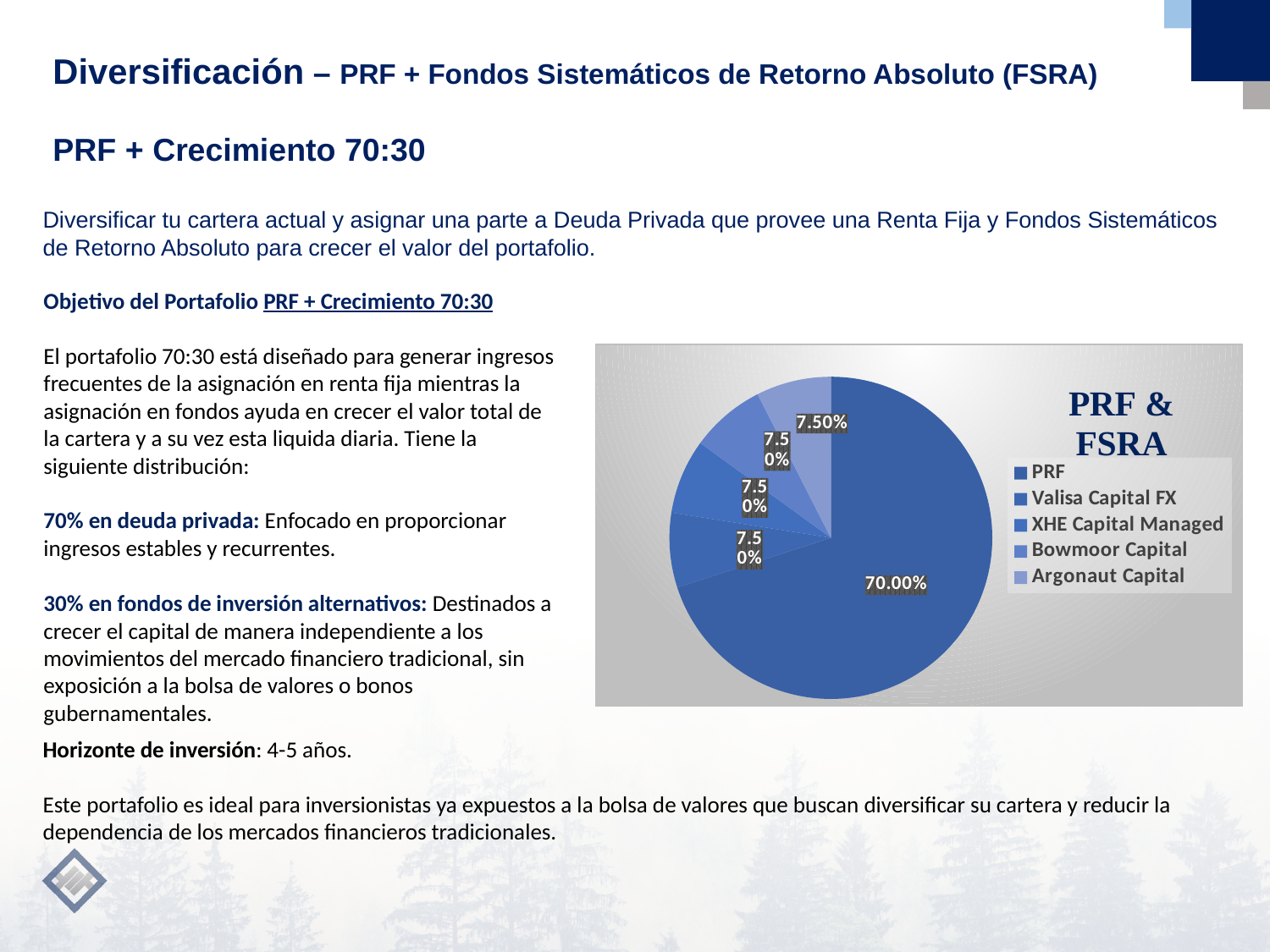
What kind of chart is shown on the slide? pie chart How many entries does the chart legend list? 5 What share of the pie does Argonaut Capital represent? 7.50% Which category has the largest slice of the pie? PRF What share of the pie does XHE Capital Managed represent? 7.50% What is the difference between the PRF slice and the Valisa Capital FX slice? 62.50% How many slices does the pie chart have? 5 What is the combined share of the four non-PRF slices (Valisa Capital FX, XHE Capital Managed, Bowmoor Capital, Argonaut Capital)? 30.00% Which is larger, the PRF slice or the Bowmoor Capital slice? PRF What share of the pie does PRF represent? 70.00% Which legend entry is listed first in the chart legend? PRF What is the title of the chart? PRF & FSRA